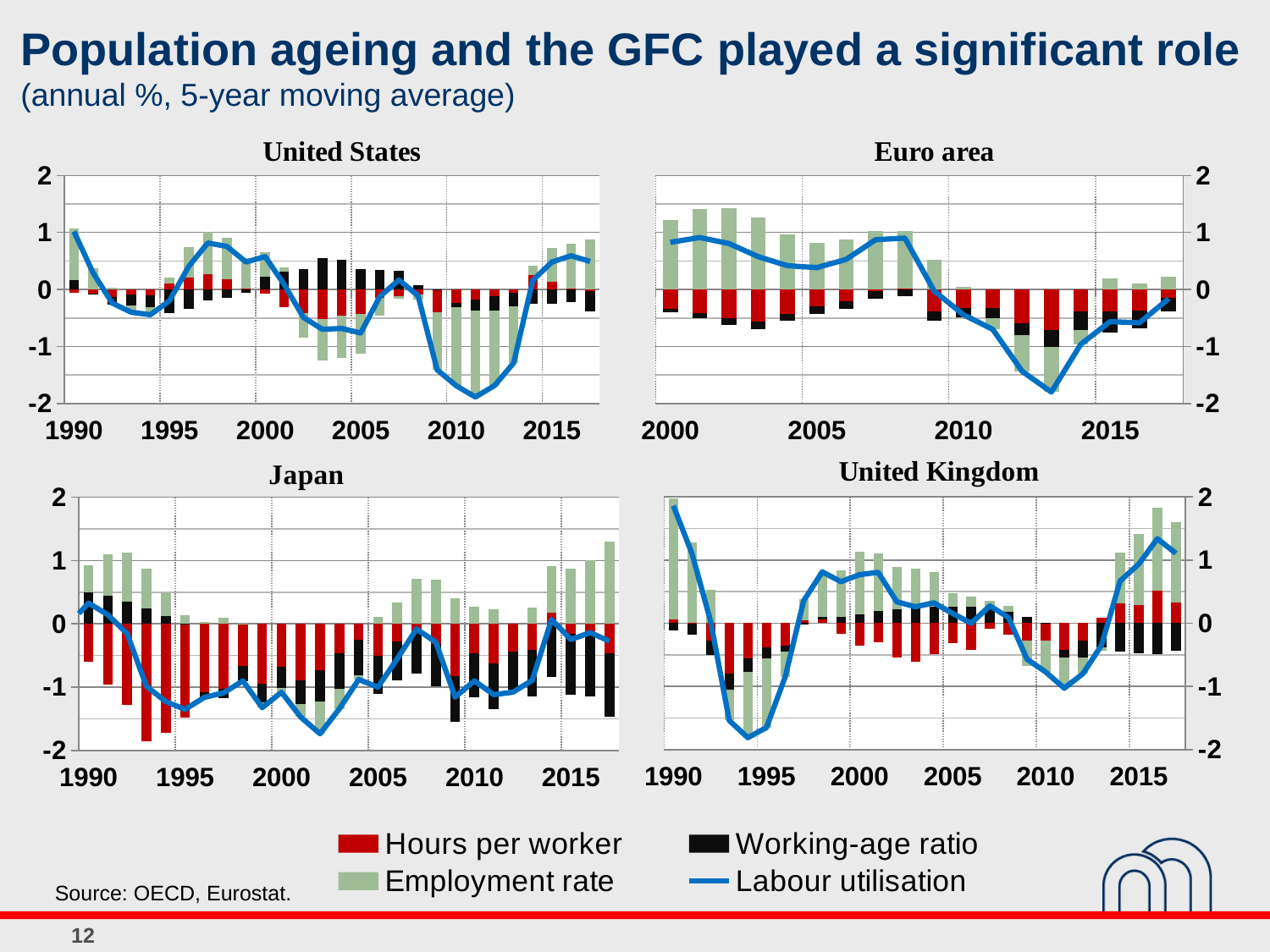
In the United Kingdom chart, does the Labour utilisation line rise or fall between 2011 and 2016? rise How many country/region charts are shown on the slide? 4 In the Euro area chart, is the Labour utilisation value for 2013 greater or less than -1? less In the United Kingdom chart, is the Labour utilisation value for 1990 greater or less than 1? greater In the Euro area chart, does the Labour utilisation line rise or fall between 2008 and 2013? fall In the Japan chart, is the Employment rate bar for 2017 greater or less than 1? greater Which series is drawn as a blue line in the charts? Labour utilisation How many series does the legend list? 4 In the United States chart, which is larger: the Labour utilisation value in 1990 or in 2011? 1990 What kind of chart is used for the United States panel? Combined bar and line chart